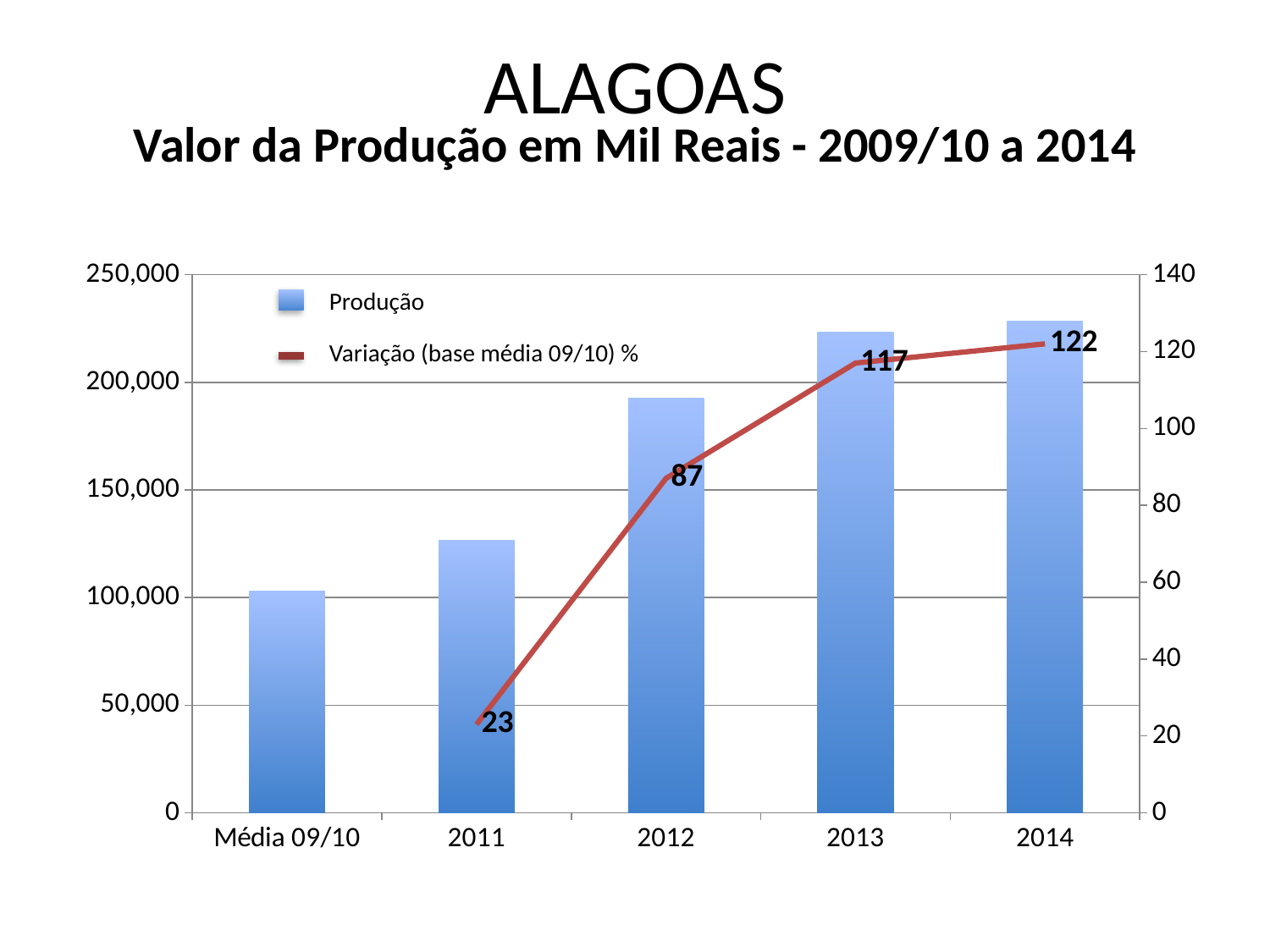
How many categories are shown on the x axis? 5 What is the difference between the Variação values for 2013 and 2011? 94 In which year is the Variação (base média 09/10) % lowest? 2011 Is the Produção value for Média 09/10 greater or less than 150,000? less What is the value of Variação (base média 09/10) % for 2011? 23 Does the Variação line rise or fall from 2011 to 2014? rises Which year has the larger Produção bar, 2011 or 2012? 2012 How many series does the legend list? 2 What is the value of Variação (base média 09/10) % for 2014? 122 What is the value of Variação (base média 09/10) % for 2012? 87 In which year is the Variação (base média 09/10) % highest? 2014 Is the Produção value for 2013 greater or less than 200,000? greater